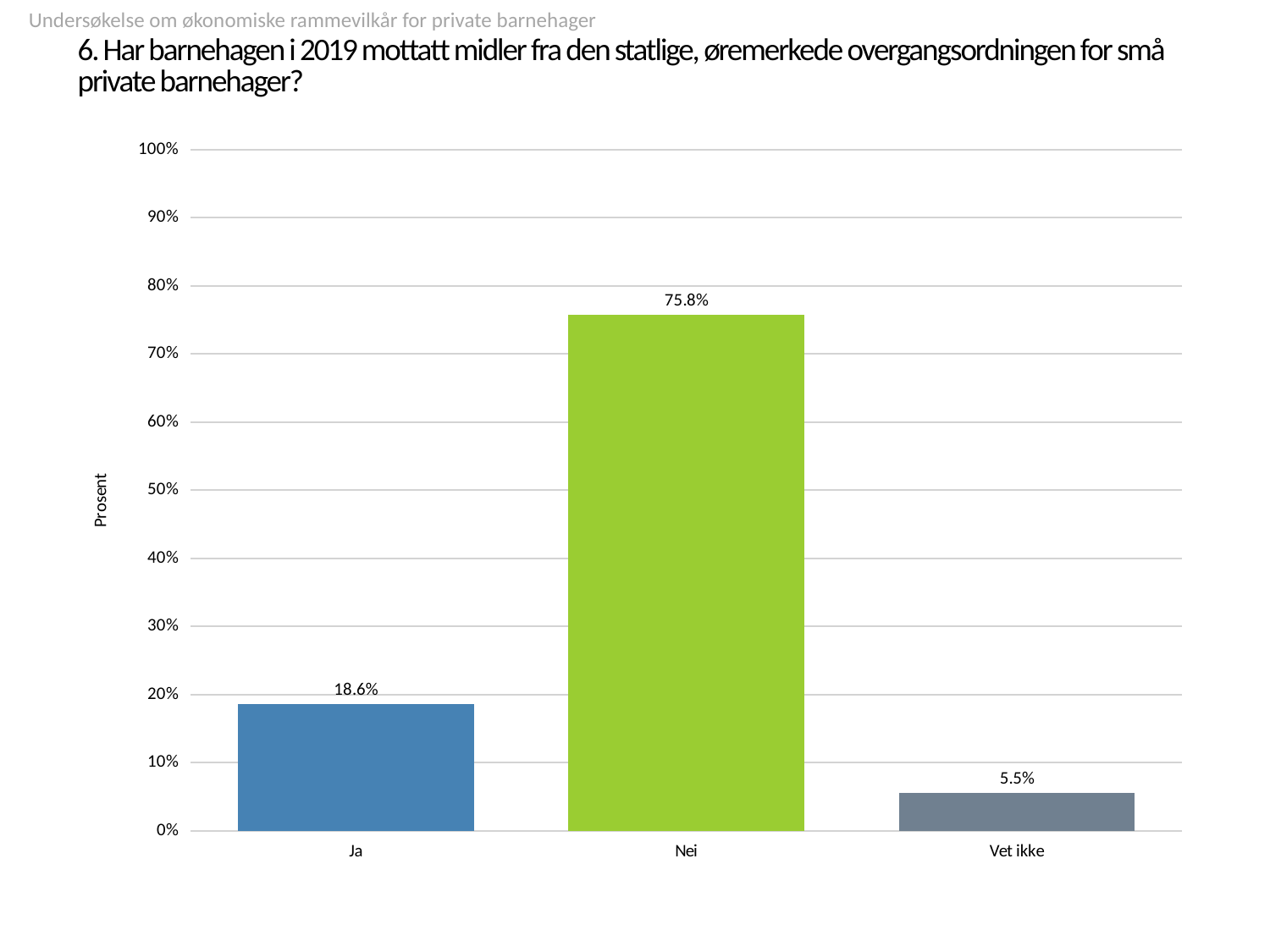
Which category has the highest value? Nei How many categories are shown on the x axis? 3 Which category has the lowest value? Vet ikke What is the label of the y axis? Prosent What is the value for "Vet ikke"? 5.5% What is the value for "Nei"? 75.8% What kind of chart is shown on the slide? bar chart Is the value for "Nei" greater or less than 70%? greater What is the difference between the values for "Ja" and "Vet ikke"? 13.1% What is the difference between the values for "Nei" and "Ja"? 57.2% Which is larger, the value for "Ja" or the value for "Vet ikke"? Ja What is the value for "Ja"? 18.6%